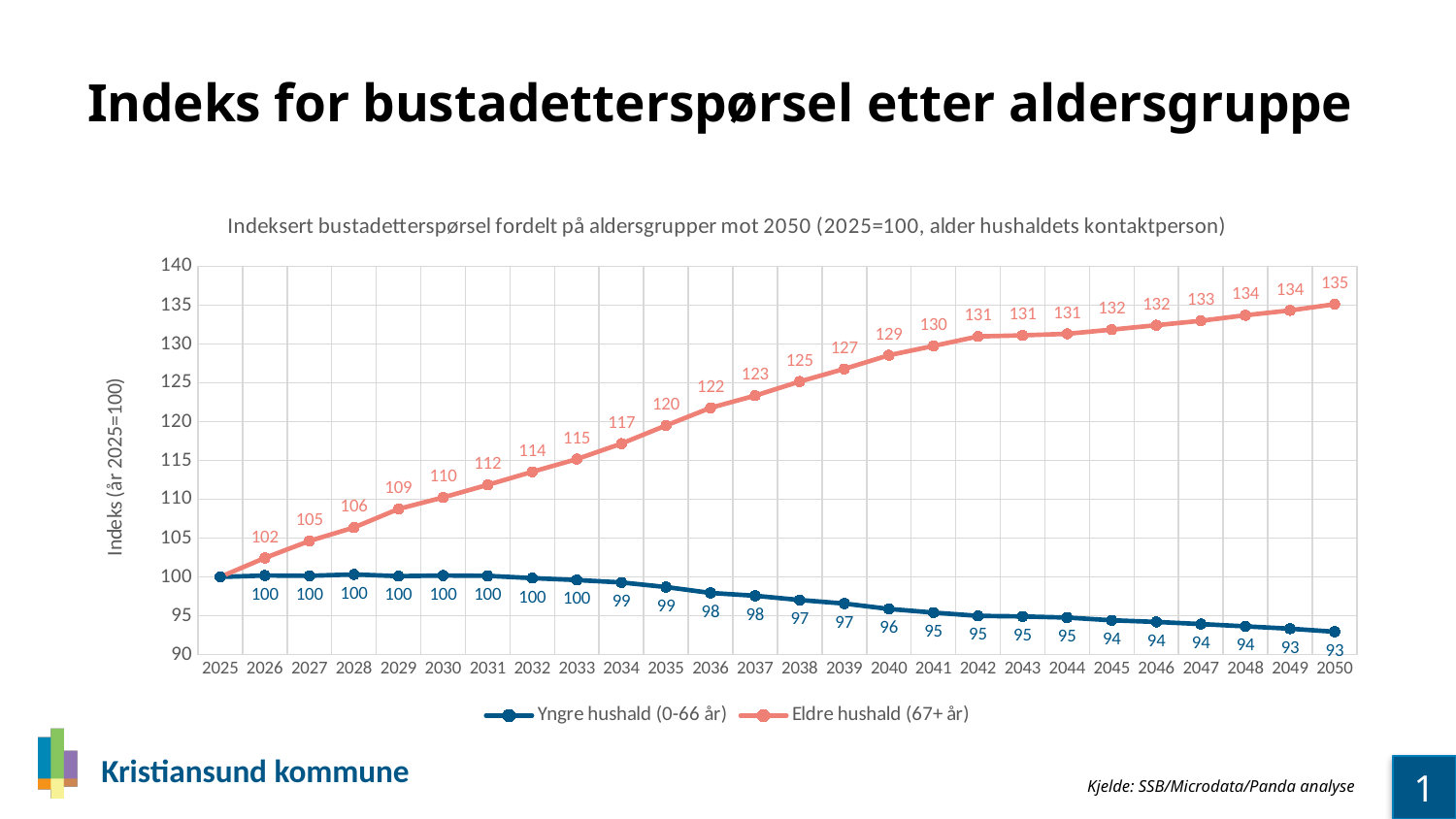
In which year does Eldre hushald (67+ år) reach its highest value? 2050 What type of chart is shown on the slide? line chart Which series has the larger value in 2045, Yngre hushald (0-66 år) or Eldre hushald (67+ år)? Eldre hushald (67+ år) What is the value for Yngre hushald (0-66 år) in 2040? 96 What is the value for Eldre hushald (67+ år) in 2035? 120 What is the title of the chart? Indeksert bustadetterspørsel fordelt på aldersgrupper mot 2050 (2025=100, alder hushaldets kontaktperson) How many years are plotted along the x axis? 26 What is the value for Eldre hushald (67+ år) in 2050? 135 How many series does the legend list? 2 What is the value for Yngre hushald (0-66 år) in 2050? 93 What is the difference between Eldre hushald (67+ år) and Yngre hushald (0-66 år) in 2050? 42 Does the value for Yngre hushald (0-66 år) rise or fall from 2025 to 2050? fall